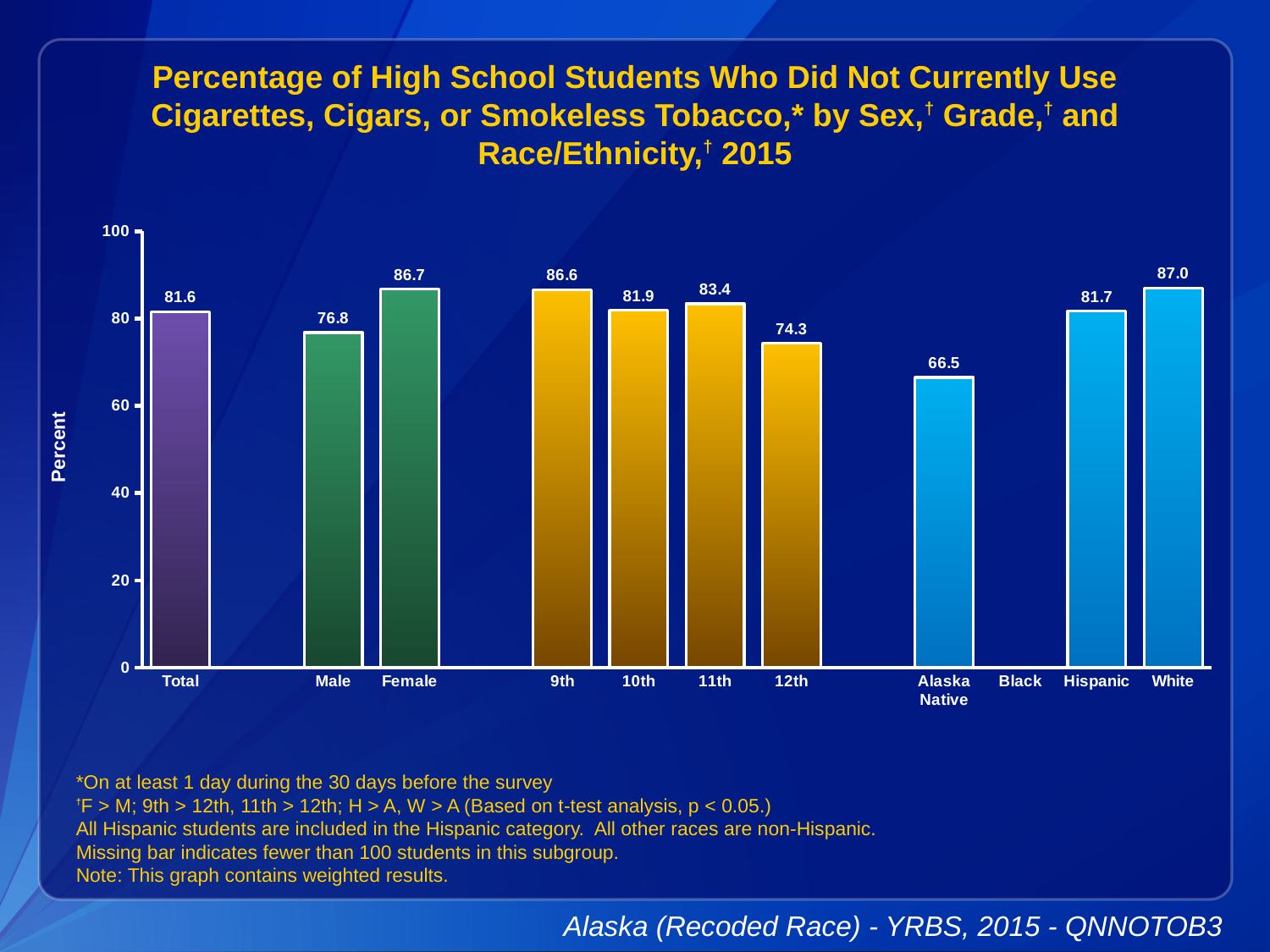
Which category has the lowest value? Alaska Native What kind of chart is shown? bar chart Is the value for Hispanic greater or less than 80? greater What is the value for 12th grade? 74.3 What is the difference between the Female and Male values? 9.9 What is the value for Alaska Native? 66.5 What is the value for Female? 86.7 Which category has the highest value? White Which category on the x axis has no bar plotted? Black How many bars are plotted on the chart? 10 Which is larger, the value for 9th grade or the value for 12th grade? 9th